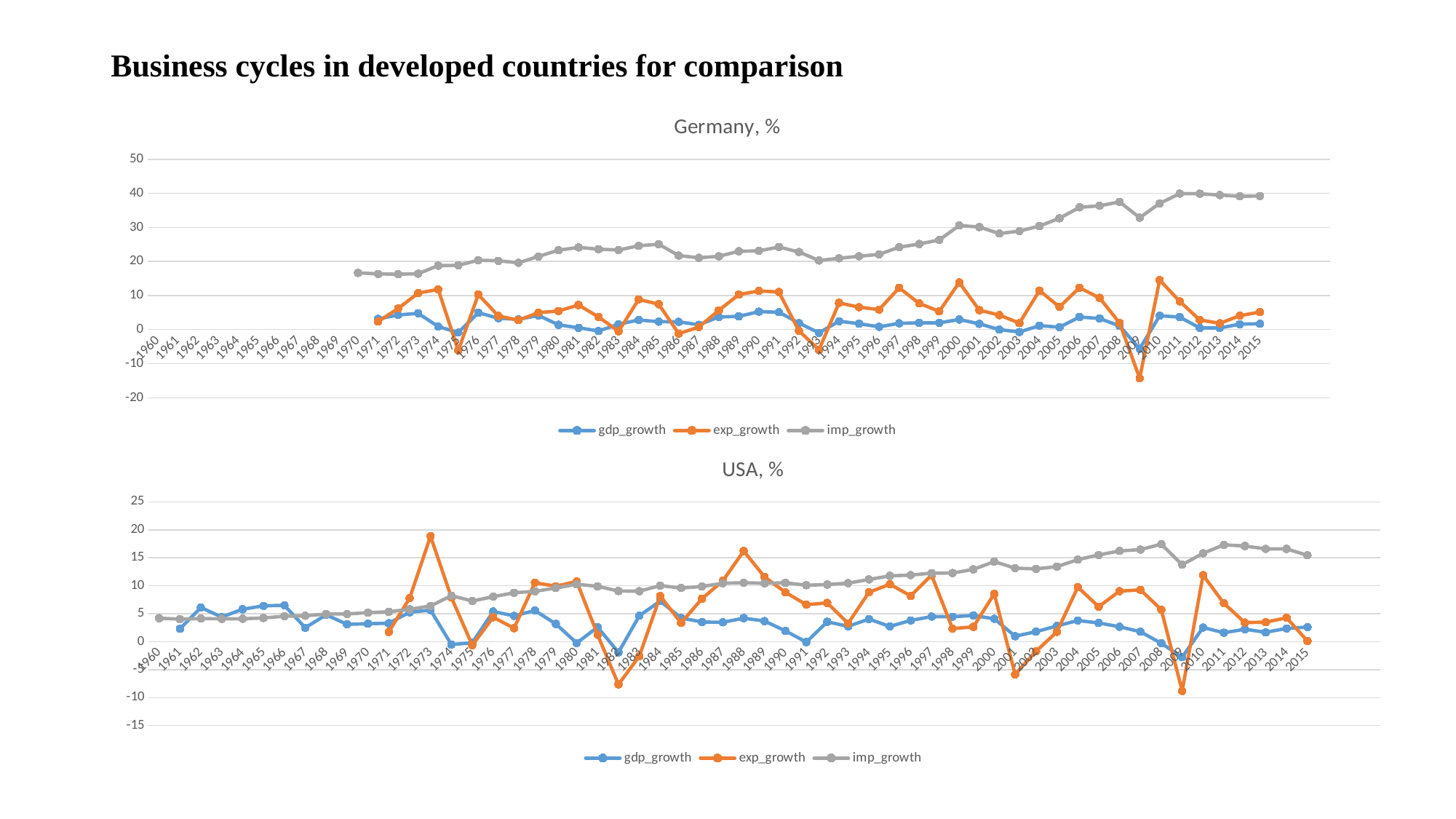
In the "Germany, %" chart, does imp_growth generally rise or fall from 1970 to 2015? rise In the "Germany, %" chart, is the imp_growth value for 1970 greater or less than 20? less In the "Germany, %" chart, is the imp_growth value for 2015 greater or less than 30? greater In the "USA, %" chart, is the imp_growth value for 2008 greater or less than 15? greater What are the three series named in the legend of the "Germany, %" chart? gdp_growth, exp_growth, imp_growth What kind of chart is the "Germany, %" chart? line chart In the "Germany, %" chart, in which year is exp_growth at its lowest? 2009 What is the title of the lower chart on the slide? USA, % In the "USA, %" chart, in which year is exp_growth at its highest? 1973 How many series does the legend of the "USA, %" chart list? 3